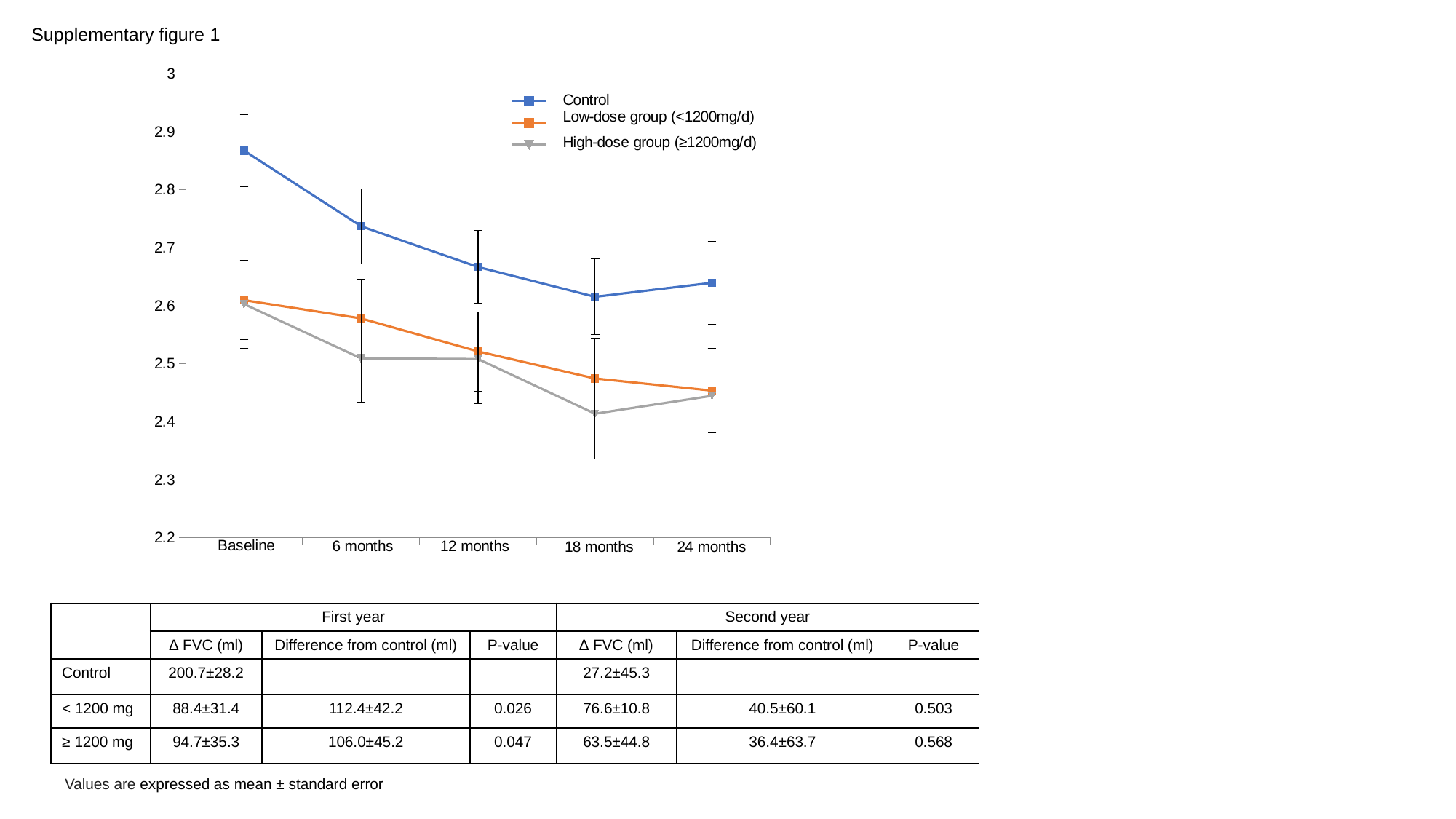
How many time points are plotted along the x axis of the chart? 5 At which time point does the Control series reach its highest value? Baseline Which series has the highest value at Baseline? Control Is the Control value at Baseline greater or less than 2.8? greater What colour is the Control line in the chart? blue At 6 months, which is larger: the Low-dose group (<1200mg/d) value or the High-dose group (≥1200mg/d) value? Low-dose group (<1200mg/d) Is the High-dose group (≥1200mg/d) value at 18 months greater or less than 2.5? less At which time point does the High-dose group (≥1200mg/d) series reach its lowest value? 18 months Does the Low-dose group (<1200mg/d) series rise or fall from Baseline to 24 months? fall How many series does the chart legend list? 3 Is the Low-dose group (<1200mg/d) value at 24 months greater or less than 2.5? less What kind of chart is shown on the slide? line chart